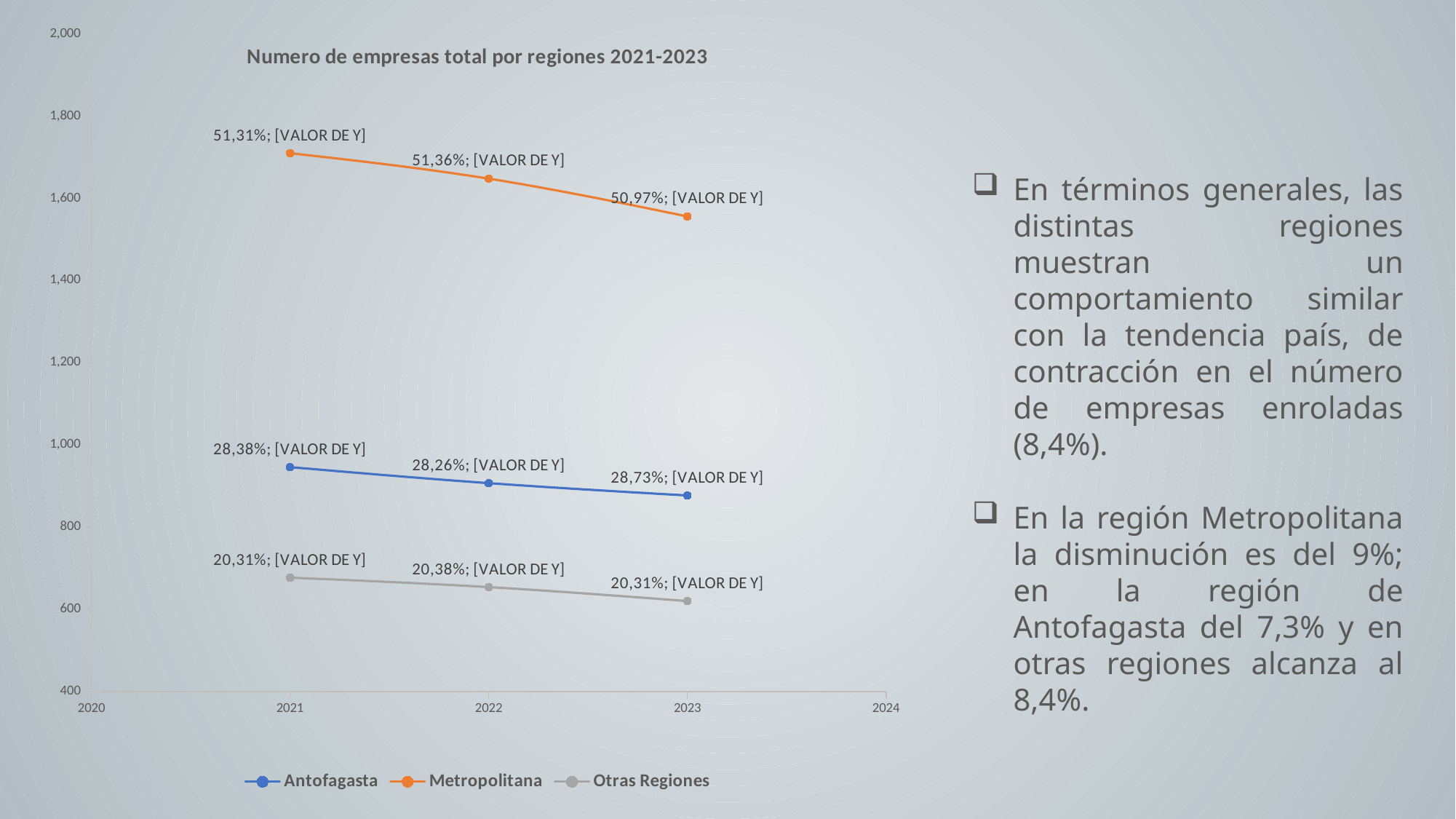
Is the value for Otras Regiones in 2023 greater or less than 600? greater How many series does the legend list? 3 Is the value for Metropolitana in 2021 greater or less than 1,600? greater Which series has the highest values across all years? Metropolitana Is the value for Antofagasta in 2021 greater or less than 1,000? less How many data points are plotted for the Metropolitana series? 3 Do the values for Antofagasta rise or fall from 2021 to 2023? Fall Which series has the lowest values across all years? Otras Regiones What percentage label is shown for the Metropolitana point in 2023? 50,97% What is the title of the chart? Numero de empresas total por regiones 2021-2023 What kind of chart is shown on the slide? Line chart